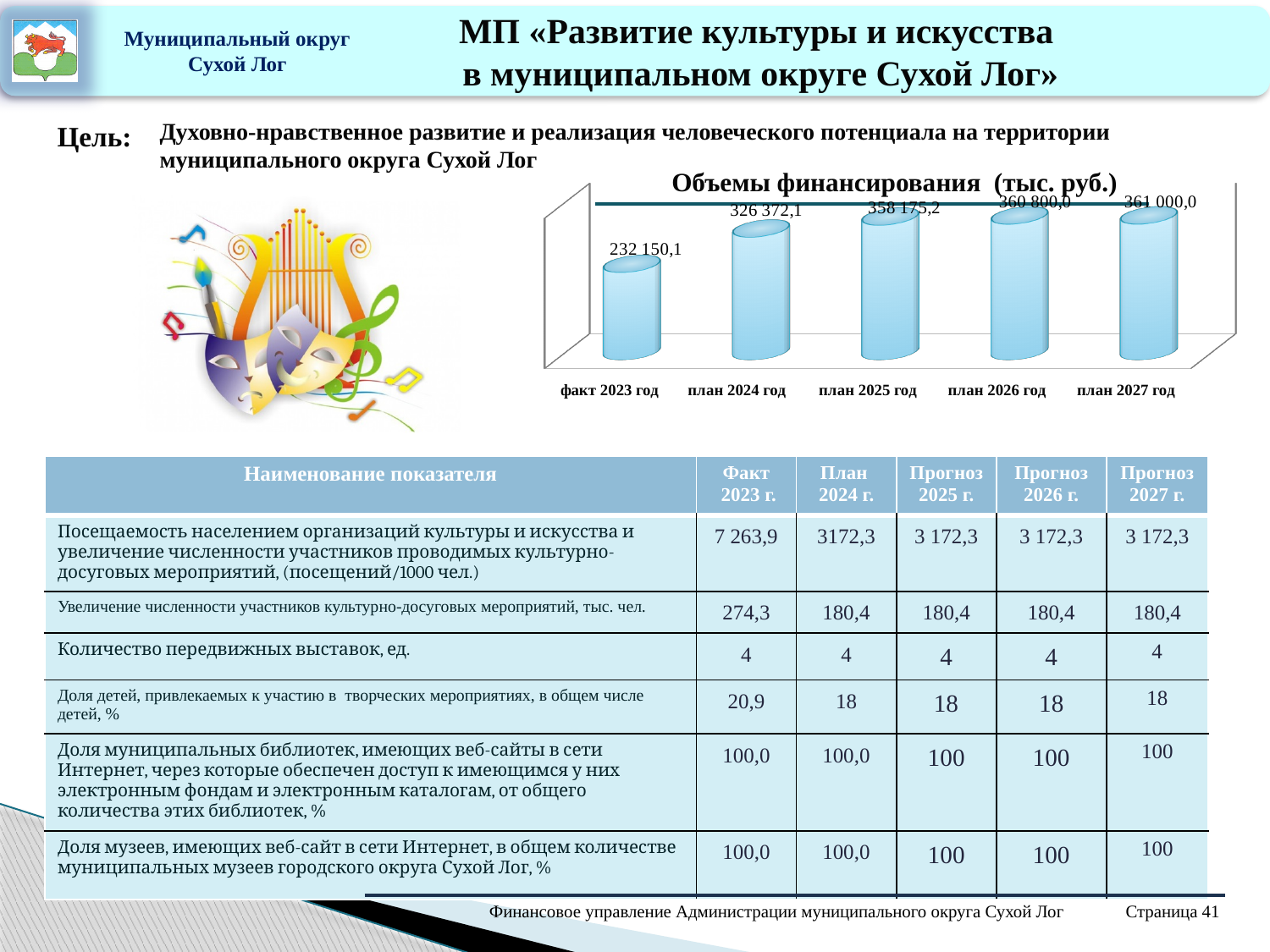
Do the values rise or fall from факт 2023 год to план 2027 год? rise What is the value for факт 2023 год in the chart? 232 150,1 What is the difference between the values for план 2025 год and план 2024 год? 31 803,1 Which category has the lowest value in the chart? факт 2023 год What is the value for план 2024 год in the chart? 326 372,1 What kind of chart is shown on the slide? bar chart What is the value for план 2027 год in the chart? 361 000,0 Which is larger, the value for план 2025 год or the value for план 2024 год? план 2025 год What is the value for план 2025 год in the chart? 358 175,2 Which category has the highest value in the chart? план 2027 год What is the difference between the values for план 2024 год and факт 2023 год? 94 222,0 How many categories are shown in the chart? 5